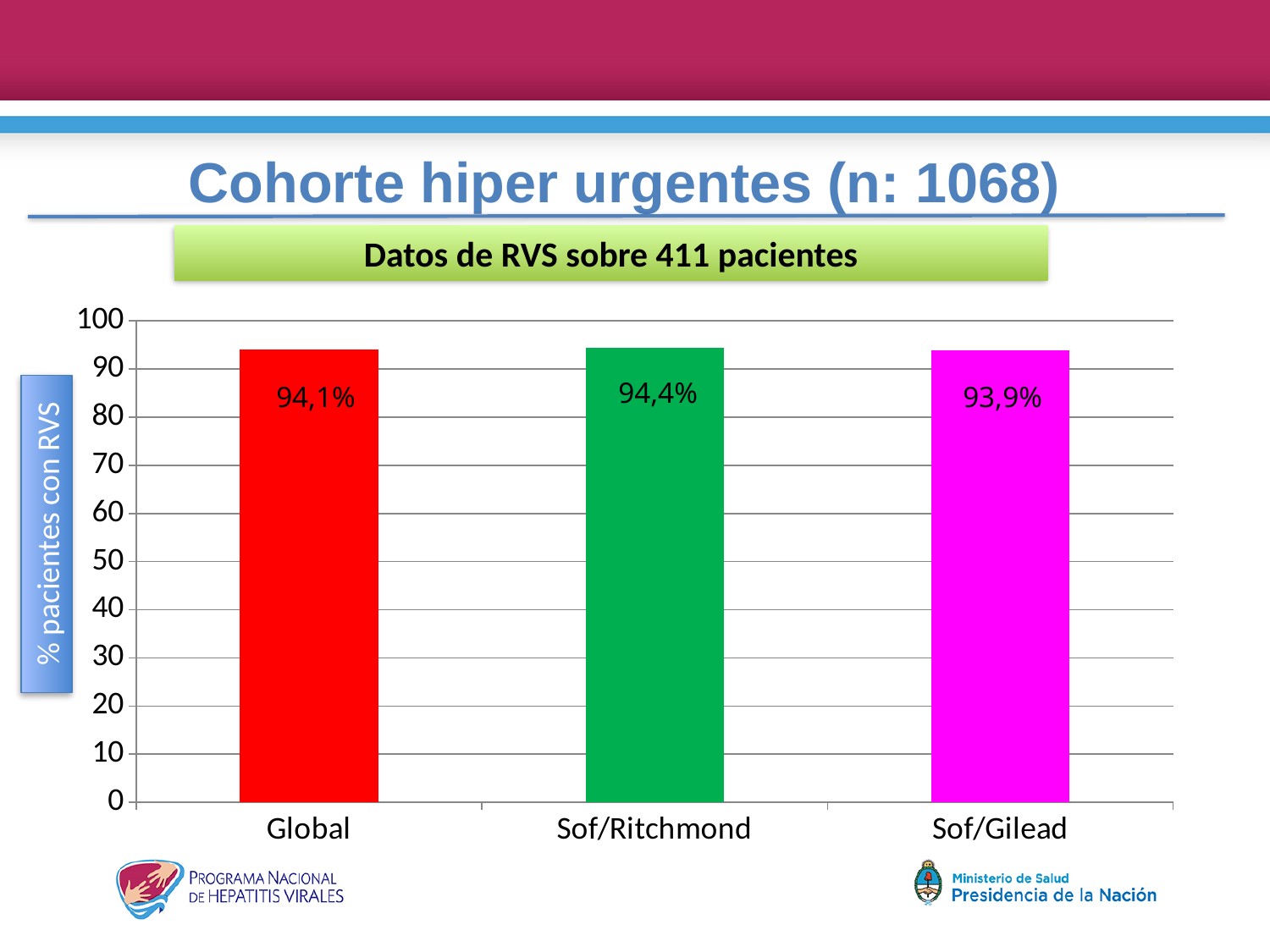
Which category has the lowest value according to the data labels? Sof/Gilead What is the difference between the values for Sof/Ritchmond and Sof/Gilead? 0,5% What is the difference between the values for Sof/Ritchmond and Global? 0,3% What is the value for Global? 94,1% According to the data labels, which is larger: the value for Global or the value for Sof/Gilead? Global Is the value for Global greater or less than 90? greater What kind of chart is shown on the slide? bar chart What is the value for Sof/Ritchmond? 94,4% How many categories are shown on the x axis? 3 What is the value for Sof/Gilead? 93,9% Which category has the highest value according to the data labels? Sof/Ritchmond What is the label of the vertical axis? % pacientes con RVS